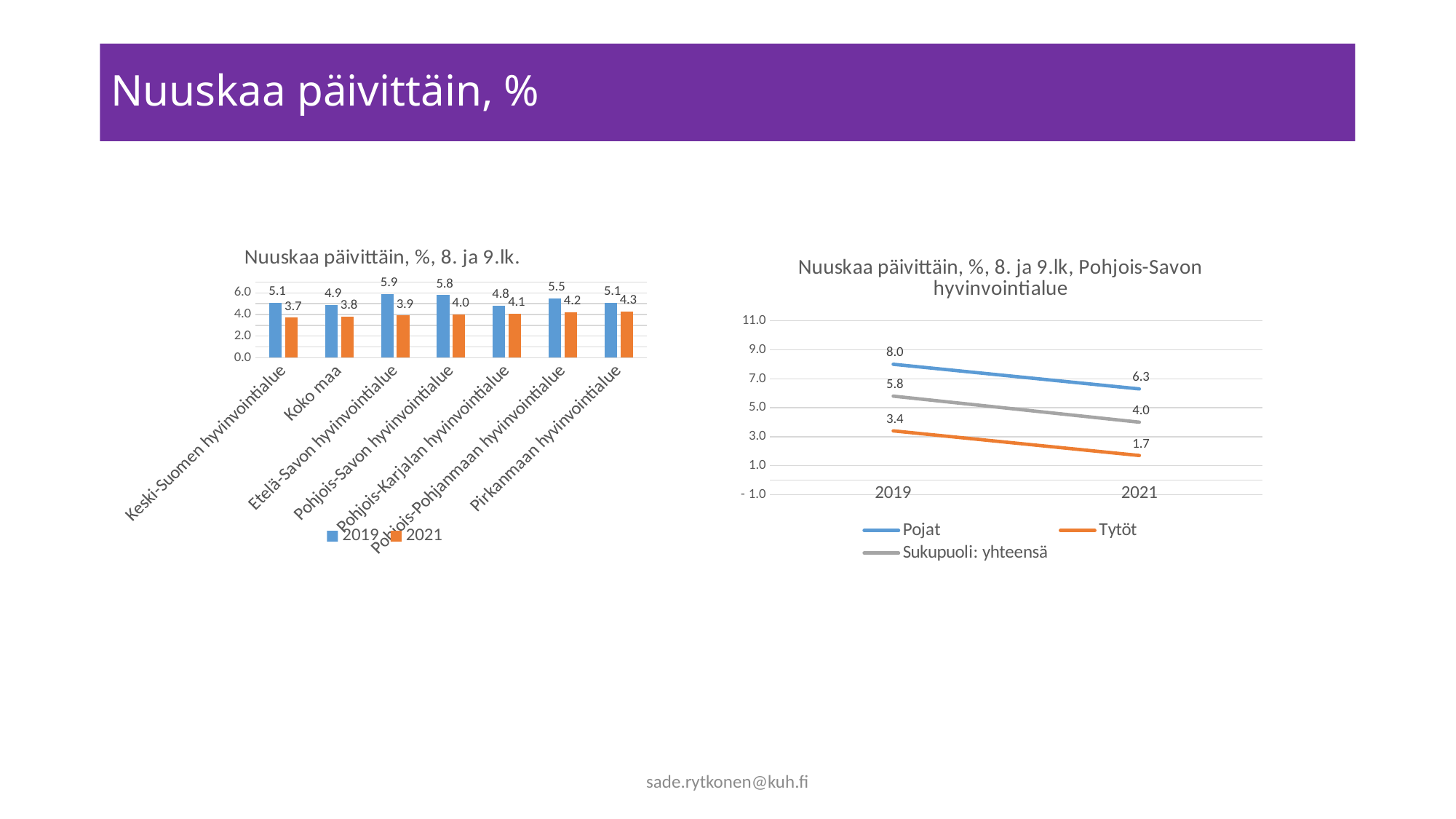
In the left chart (Nuuskaa päivittäin, %, 8. ja 9.lk.), how many categories are shown on the x axis? 7 In the right chart (Pohjois-Savon hyvinvointialue), how many series does the legend list? 3 In the left chart (Nuuskaa päivittäin, %, 8. ja 9.lk.), what is the difference between the 2019 and 2021 values for Pohjois-Savon hyvinvointialue? 1.8 What kind of chart is the left chart (Nuuskaa päivittäin, %, 8. ja 9.lk.)? Bar chart In the right chart (Pohjois-Savon hyvinvointialue), does the Sukupuoli: yhteensä line rise or fall from 2019 to 2021? Fall In the left chart (Nuuskaa päivittäin, %, 8. ja 9.lk.), what is the 2021 value for Koko maa? 3.8 In the right chart (Pohjois-Savon hyvinvointialue), what is the difference between the Pojat and Tytöt values in 2019? 4.6 In the right chart (Pohjois-Savon hyvinvointialue), what is the value for Tytöt in 2019? 3.4 In the right chart (Pohjois-Savon hyvinvointialue), what is the value for Pojat in 2021? 6.3 In the left chart (Nuuskaa päivittäin, %, 8. ja 9.lk.), which category has the highest 2019 value? Etelä-Savon hyvinvointialue In the left chart (Nuuskaa päivittäin, %, 8. ja 9.lk.), what is the 2019 value for Etelä-Savon hyvinvointialue? 5.9 In the left chart (Nuuskaa päivittäin, %, 8. ja 9.lk.), which category has the lowest 2021 value? Keski-Suomen hyvinvointialue